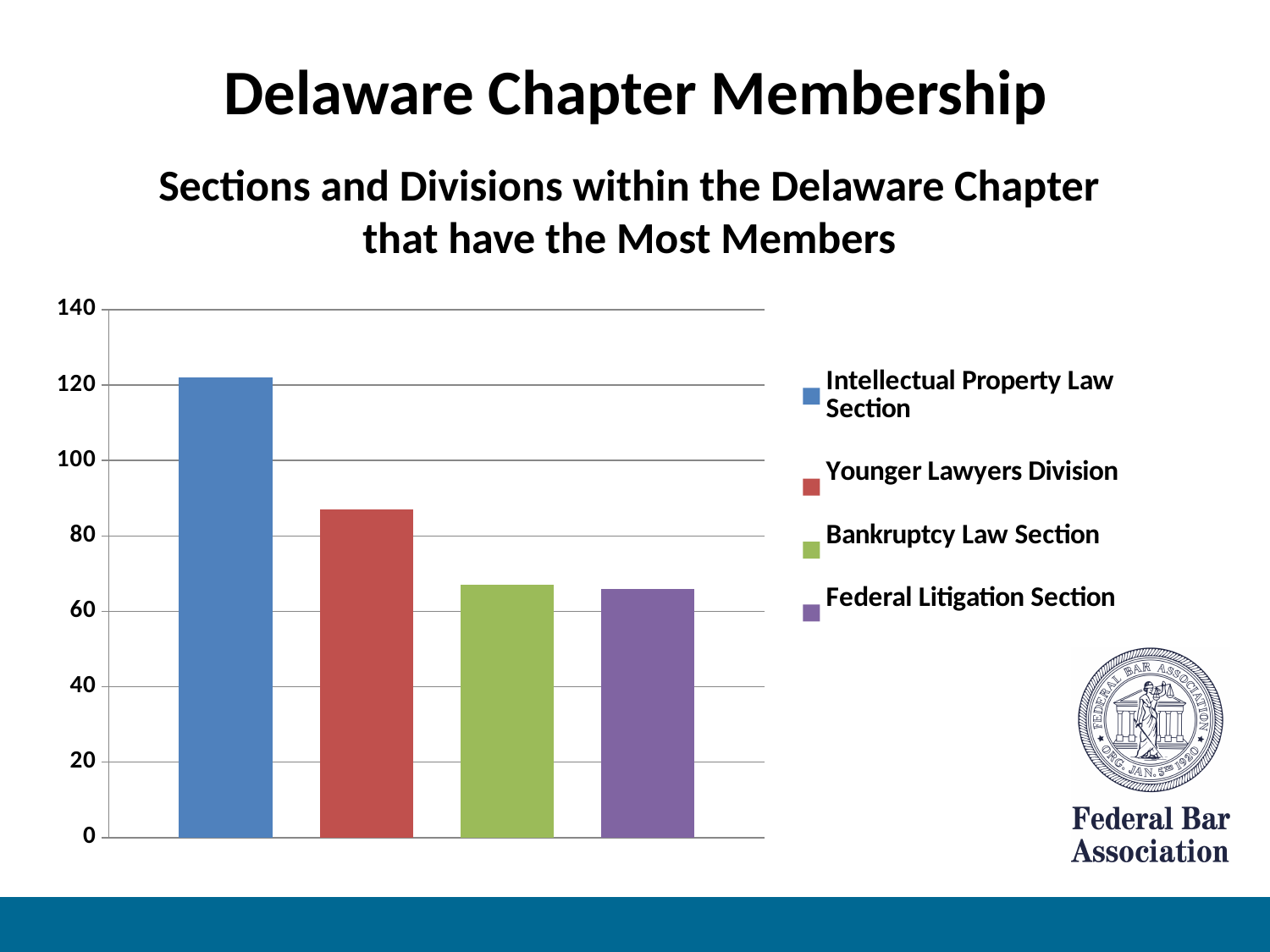
Do the bar values rise or fall from left to right across the chart? fall Which is larger, the value for the Intellectual Property Law Section or the value for the Younger Lawyers Division? Intellectual Property Law Section Is the value for the Federal Litigation Section greater or less than 60? greater What is the title of the chart? Sections and Divisions within the Delaware Chapter that have the Most Members How many entries does the chart's legend list? 4 How many bars are plotted in the chart? 4 Which section or division has the highest membership in the chart? Intellectual Property Law Section Is the value for the Bankruptcy Law Section greater or less than 80? less Is the value for the Younger Lawyers Division greater or less than 100? less What kind of chart is shown on the slide? bar chart